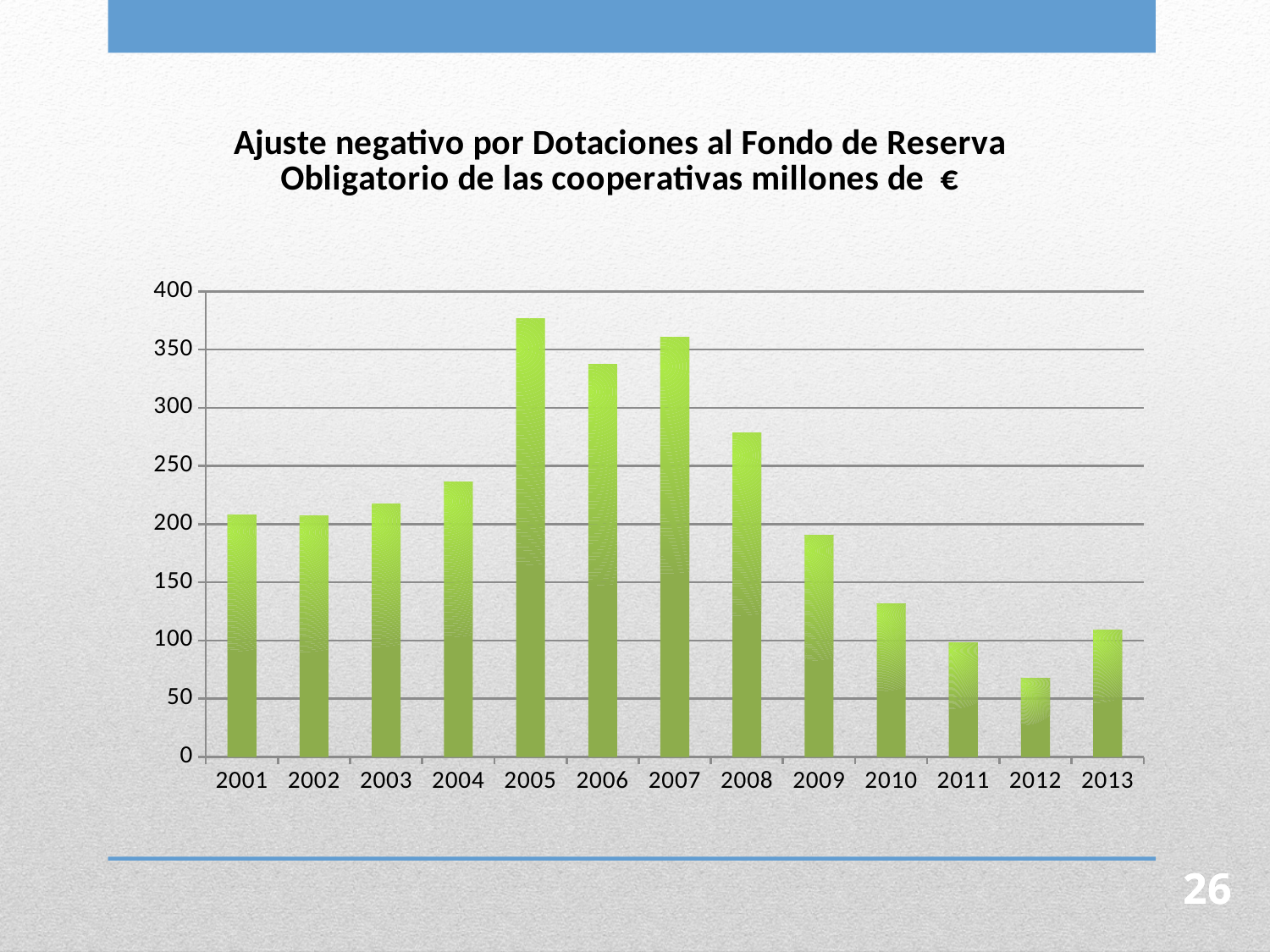
Is the value for 2012 greater or less than 50? greater Is the value for 2005 greater or less than 350? greater What kind of chart is shown on the slide? bar chart What unit does the chart title say the values are in? millones de € Which year has the lowest value in the chart? 2012 Which is larger, the value for 2006 or the value for 2007? 2007 Is the value for 2004 greater or less than 250? less Do the values rise or fall from 2008 to 2012? fall How many years are shown on the x axis of the chart? 13 Which year has the highest value in the chart? 2005